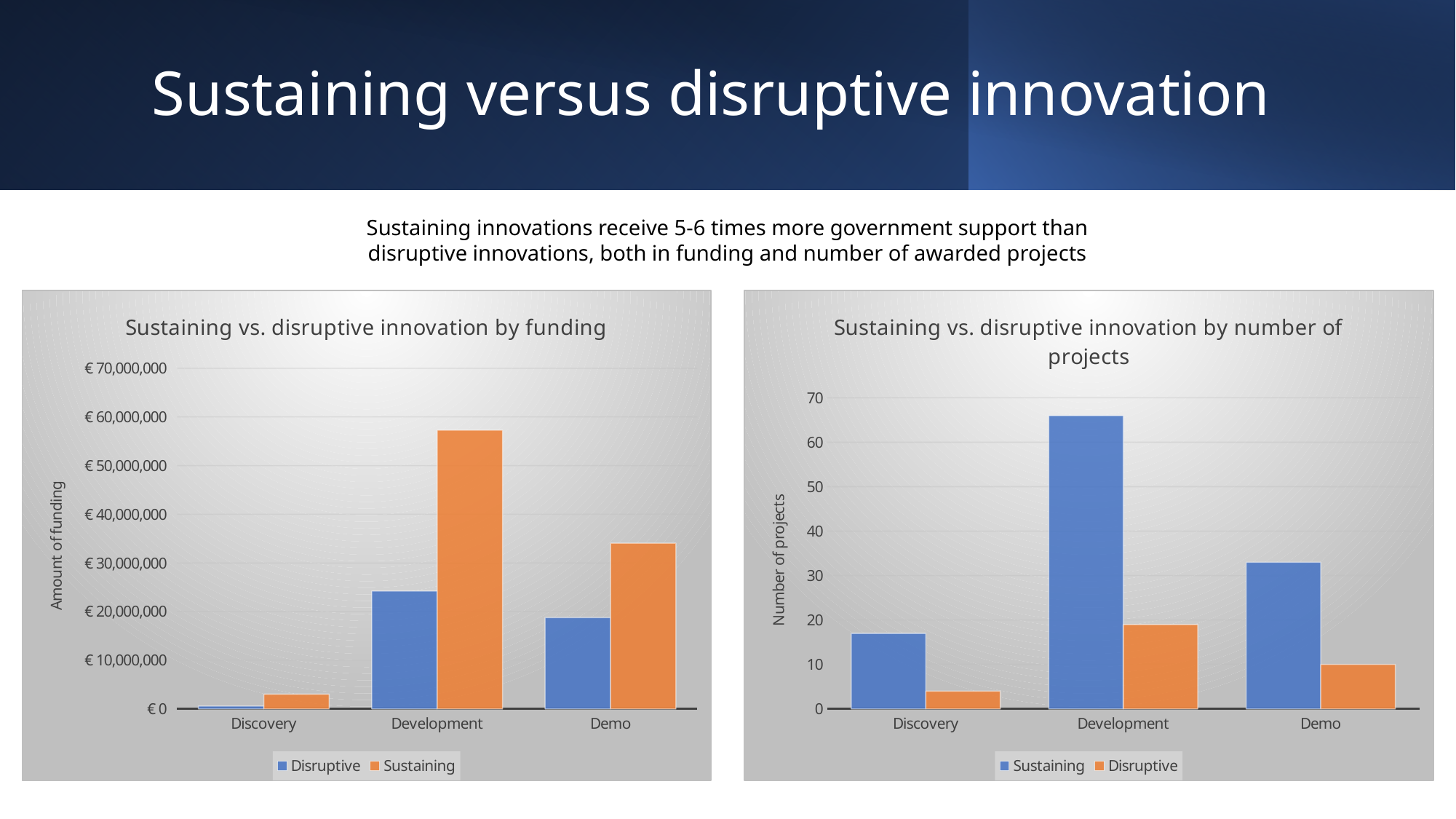
In the chart titled "Sustaining vs. disruptive innovation by funding", which category has the lowest Disruptive funding? Discovery In the chart titled "Sustaining vs. disruptive innovation by funding", how many categories are shown on the x axis? 3 In the chart titled "Sustaining vs. disruptive innovation by number of projects", which is larger for Discovery: Sustaining or Disruptive projects? Sustaining In the chart titled "Sustaining vs. disruptive innovation by number of projects", which category has the highest number of Sustaining projects? Development In the chart titled "Sustaining vs. disruptive innovation by funding", which category has the highest Sustaining funding? Development In the chart titled "Sustaining vs. disruptive innovation by funding", is the Sustaining funding for Development greater or less than € 50,000,000? greater In the chart titled "Sustaining vs. disruptive innovation by number of projects", what is the label of the y axis? Number of projects In the chart titled "Sustaining vs. disruptive innovation by funding", which is larger for Demo: Disruptive or Sustaining funding? Sustaining In the chart titled "Sustaining vs. disruptive innovation by funding", how many series does the legend list? 2 In the chart titled "Sustaining vs. disruptive innovation by number of projects", is the number of Sustaining projects for Development greater or less than 60? greater In the chart titled "Sustaining vs. disruptive innovation by funding", what kind of chart is shown? bar chart In the chart titled "Sustaining vs. disruptive innovation by funding", is the Disruptive funding for Demo greater or less than € 20,000,000? less